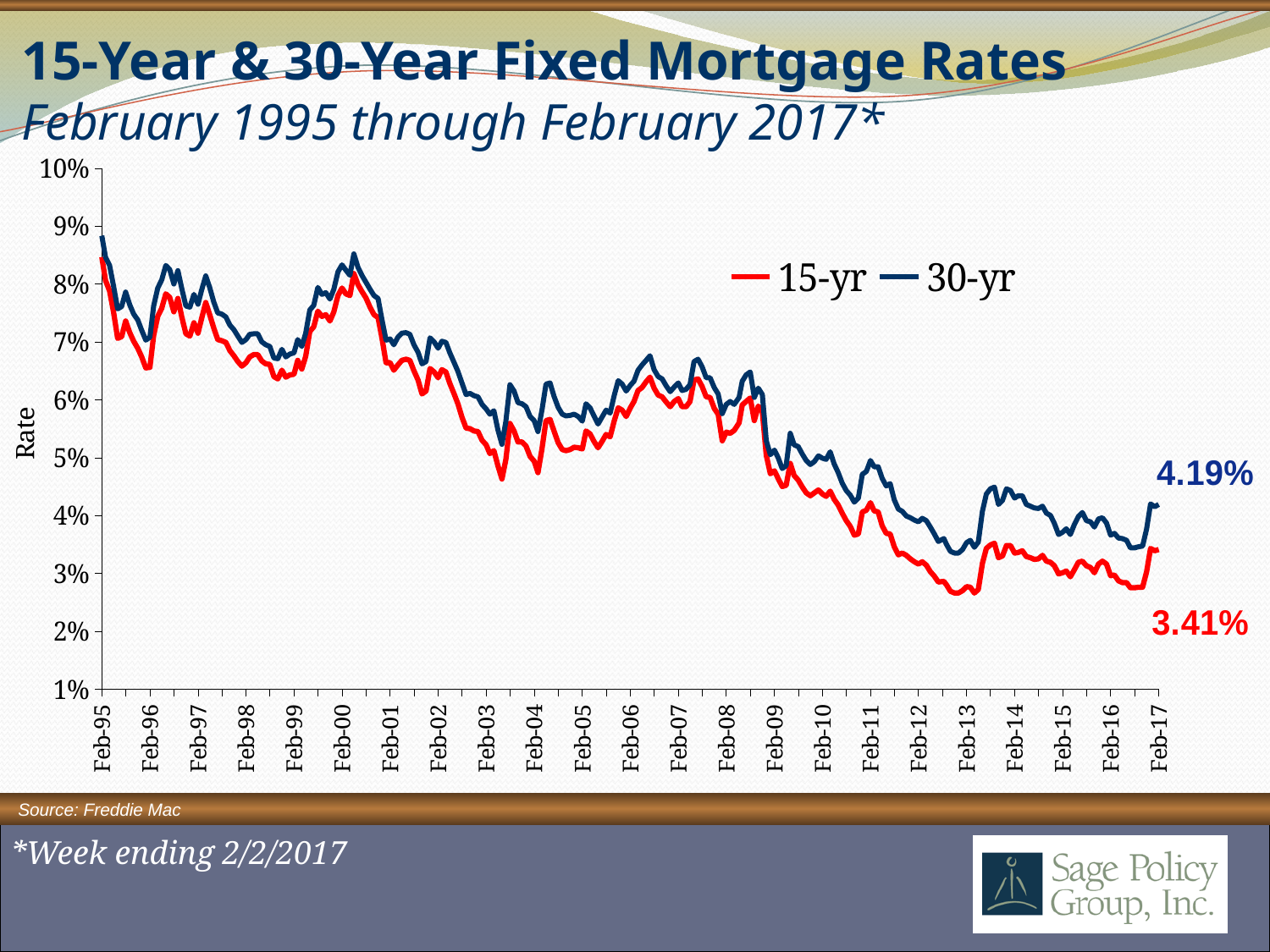
What colour is the 15-yr line? red Do mortgage rates generally rise or fall from Feb-95 to Feb-17? fall What is the 15-yr fixed mortgage rate at Feb-17? 3.41% Is the 30-yr rate at Feb-09 greater or less than 6%? less What kind of chart is shown on the slide? line chart What is the 30-yr fixed mortgage rate at Feb-17? 4.19% Which series has the higher rate at Feb-17, 15-yr or 30-yr? 30-yr Is the 15-yr rate at Feb-13 greater or less than 3%? less Is the 30-yr rate at Feb-95 greater or less than 8%? greater What is the difference between the 30-yr and 15-yr rates at Feb-17? 0.78 percentage points How many series does the legend list? 2 What is the source of the data shown in the chart? Freddie Mac